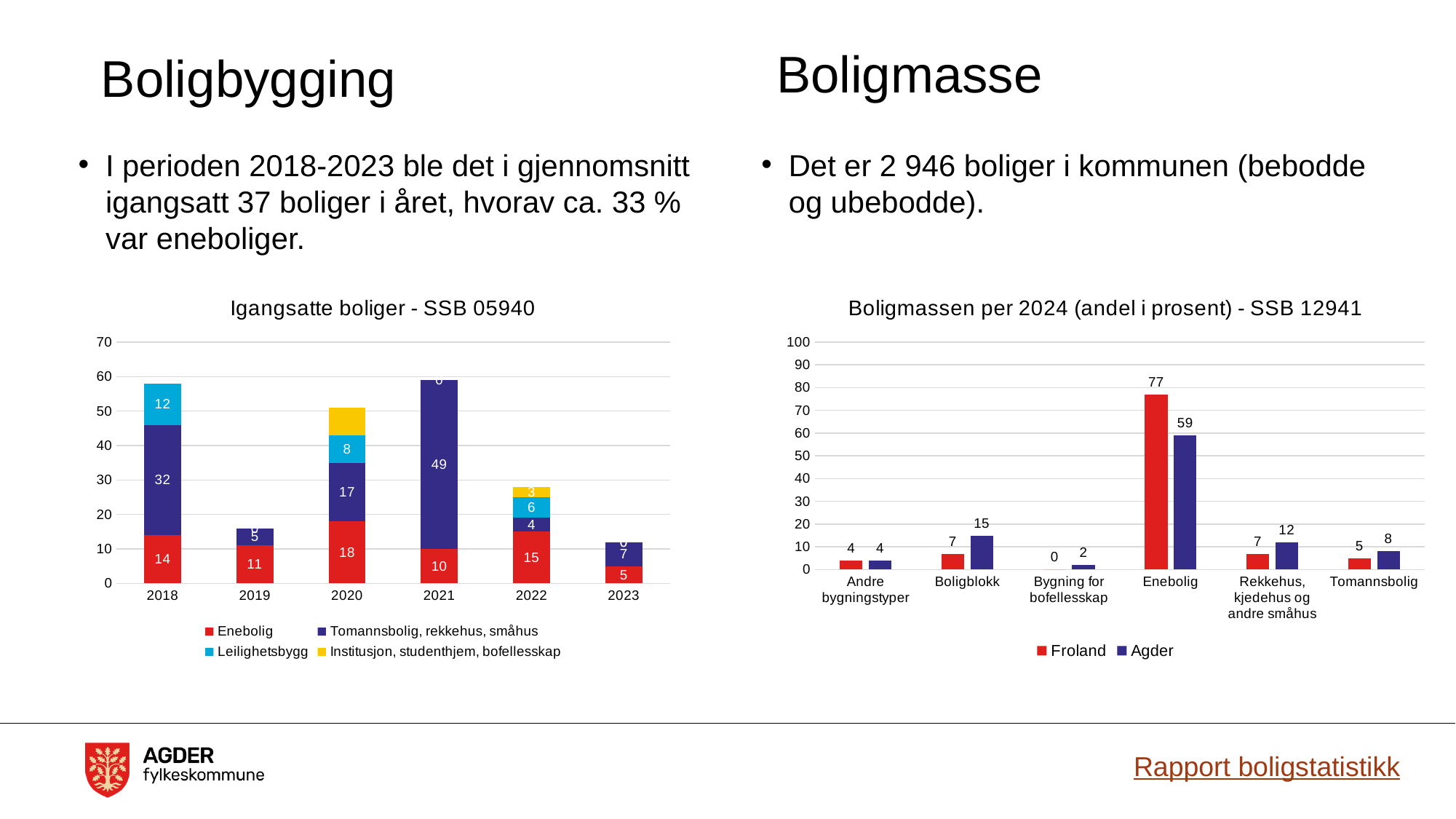
In the chart 'Igangsatte boliger - SSB 05940', what is the value for Tomannsbolig, rekkehus, småhus in 2021? 49 In the chart 'Igangsatte boliger - SSB 05940', what is the value for Enebolig in 2020? 18 In the chart 'Boligmassen per 2024 (andel i prosent) - SSB 12941', what is the difference between the Froland and Agder values for Enebolig? 18 In the chart 'Igangsatte boliger - SSB 05940', how many series does the legend list? 4 In the chart 'Igangsatte boliger - SSB 05940', what is the total of the stacked bar for 2022? 28 In the chart 'Boligmassen per 2024 (andel i prosent) - SSB 12941', how many categories are shown on the x axis? 6 In the chart 'Igangsatte boliger - SSB 05940', what is the total of the stacked bar for 2018? 58 In the chart 'Igangsatte boliger - SSB 05940', which year has the lowest Enebolig value? 2023 In the chart 'Boligmassen per 2024 (andel i prosent) - SSB 12941', what is the value for Agder for Boligblokk? 15 In the chart 'Igangsatte boliger - SSB 05940', what is the difference between the Enebolig values for 2020 and 2023? 13 What kind of chart is 'Boligmassen per 2024 (andel i prosent) - SSB 12941'? Bar chart In the chart 'Boligmassen per 2024 (andel i prosent) - SSB 12941', what is the value for Froland for Enebolig? 77